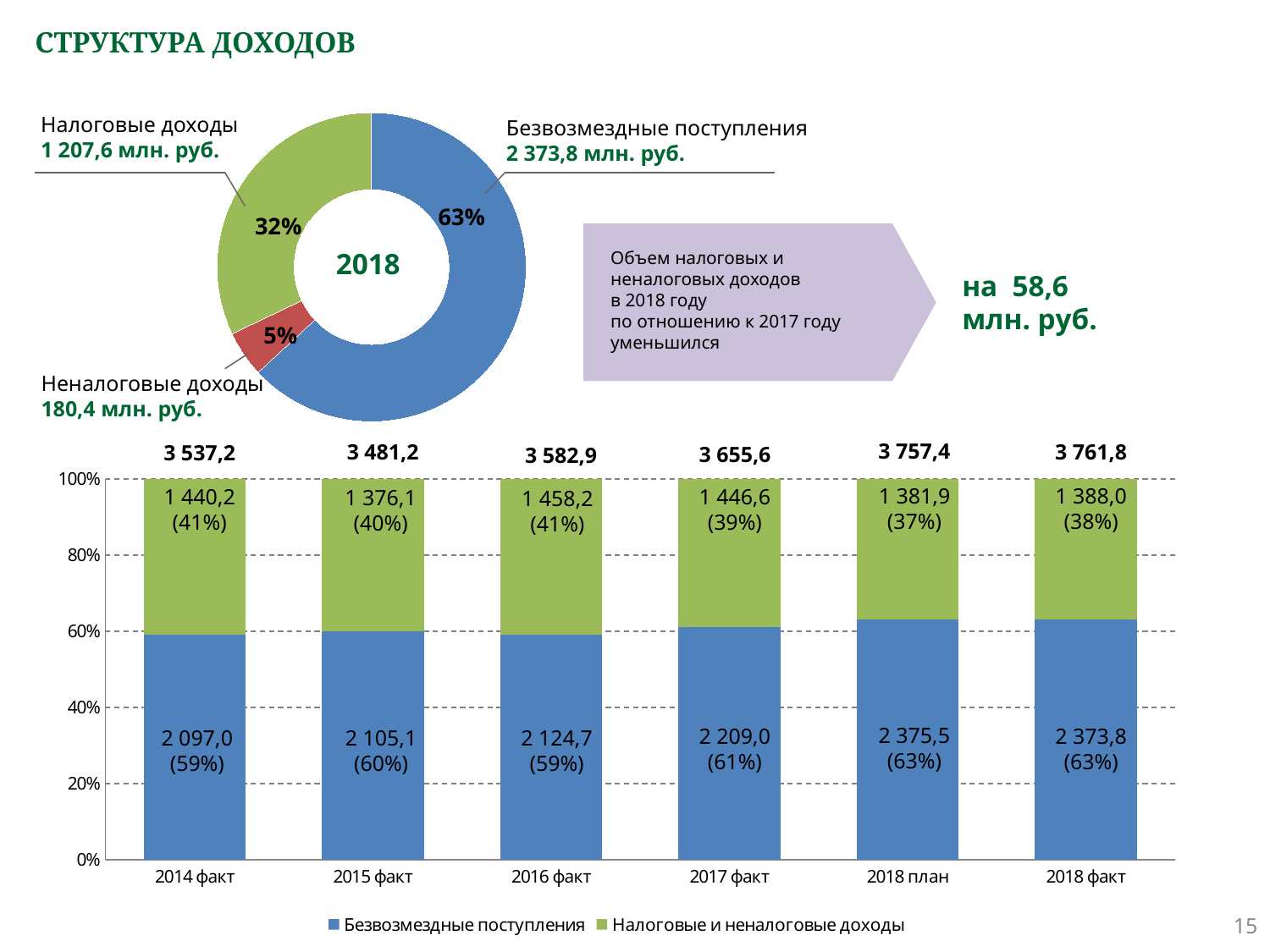
In the stacked bar chart at the bottom, how many categories are shown on the x axis? 6 In the donut chart for 2018, which category has the smallest slice? Неналоговые доходы In the donut chart for 2018, what is the value for Налоговые доходы? 1 207,6 млн. руб. In the stacked bar chart at the bottom, which category has the highest value for Налоговые и неналоговые доходы? 2016 факт In the stacked bar chart at the bottom, what is the value of Безвозмездные поступления for 2017 факт? 2 209,0 (61%) In the donut chart for 2018, what is the value for Неналоговые доходы? 180,4 млн. руб. In the stacked bar chart at the bottom, how many series does the legend list? 2 In the stacked bar chart at the bottom, which is larger: Безвозмездные поступления for 2014 факт or for 2015 факт? 2015 факт In the stacked bar chart at the bottom, what is the difference between Безвозмездные поступления for 2018 план and 2018 факт? 1,7 What kind of chart is shown at the bottom of the slide? Stacked bar chart In the donut chart for 2018, what share of income is Безвозмездные поступления? 63% In the stacked bar chart at the bottom, what is the total shown above the bar for 2018 факт? 3 761,8